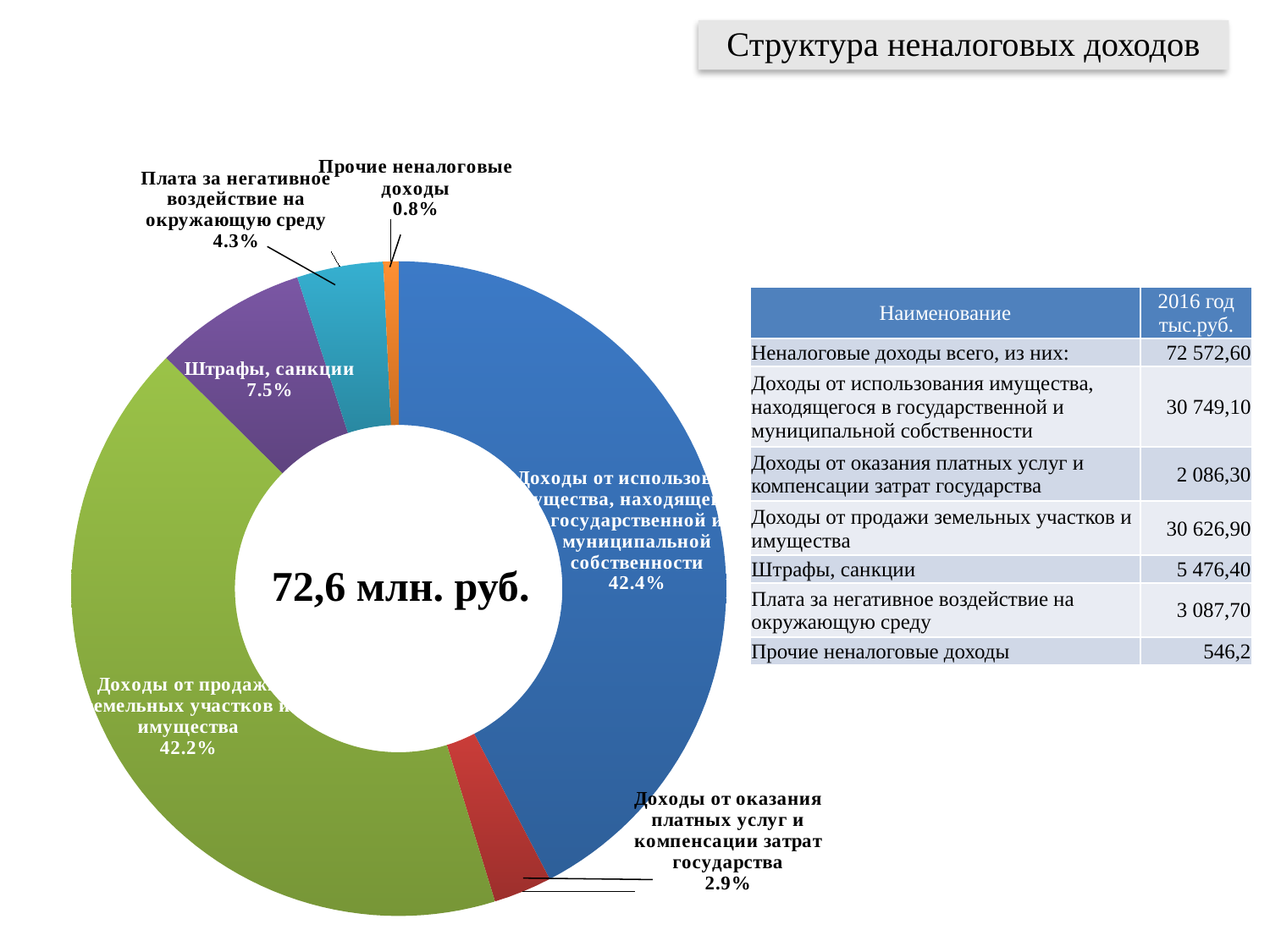
By how many percentage points does the share of Штрафы, санкции exceed that of Плата за негативное воздействие на окружающую среду? 3.2 What percentage is shown for Прочие неналоговые доходы? 0.8% What percentage is shown for Доходы от оказания платных услуг и компенсации затрат государства? 2.9% Which category has the smallest share in the chart? Прочие неналоговые доходы How many categories are shown in the chart? 6 What share of the doughnut chart is labelled for Штрафы, санкции? 7.5% What total amount is written in the centre of the chart? 72,6 млн. руб. What type of chart is shown on the slide? Doughnut (pie) chart What percentage is shown for Доходы от продажи земельных участков и имущества? 42.2% Which share is larger: Штрафы, санкции or Плата за негативное воздействие на окружающую среду? Штрафы, санкции What percentage is shown for Плата за негативное воздействие на окружающую среду? 4.3% What is the title of the slide? Структура неналоговых доходов